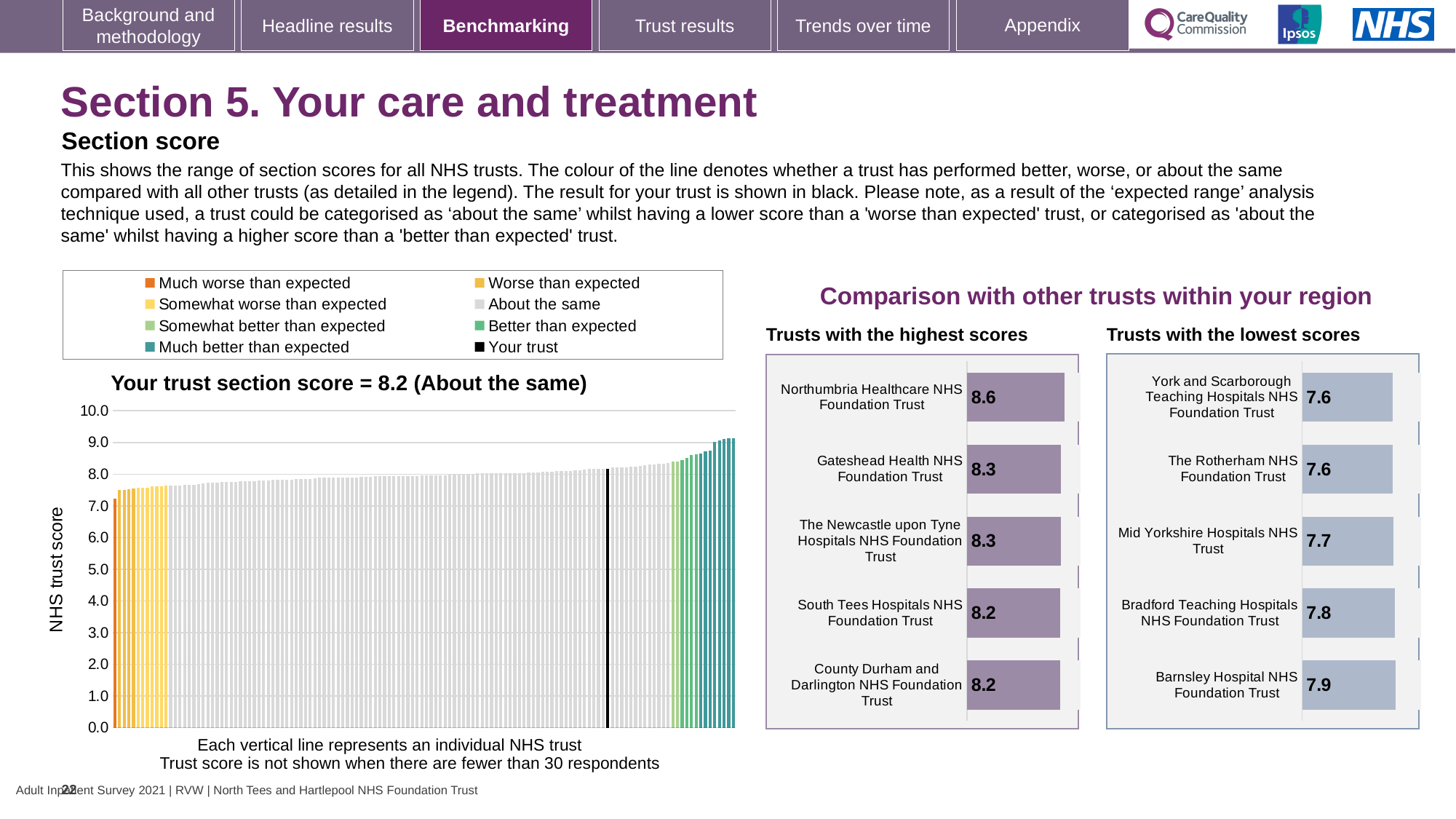
In the 'Trusts with the lowest scores' chart, what is the score for Mid Yorkshire Hospitals NHS Trust? 7.7 What kind of chart is the 'Trusts with the highest scores' chart? Bar chart How many entries does the legend of the main chart of all NHS trusts list? 8 How many trusts are shown in the 'Trusts with the lowest scores' chart? 5 In the 'Trusts with the lowest scores' chart, which trust has the highest score? Barnsley Hospital NHS Foundation Trust In the 'Trusts with the lowest scores' chart, what is the difference between the scores of Barnsley Hospital NHS Foundation Trust and York and Scarborough Teaching Hospitals NHS Foundation Trust? 0.3 In the 'Trusts with the highest scores' chart, what is the difference between the scores of Northumbria Healthcare NHS Foundation Trust and Gateshead Health NHS Foundation Trust? 0.3 In the 'Trusts with the highest scores' chart, what is the score for Northumbria Healthcare NHS Foundation Trust? 8.6 How many trusts are shown in the 'Trusts with the highest scores' chart? 5 In the 'Trusts with the lowest scores' chart, which has the larger score: Bradford Teaching Hospitals NHS Foundation Trust or Barnsley Hospital NHS Foundation Trust? Barnsley Hospital NHS Foundation Trust In the main chart of all NHS trusts, what is your trust's section score? 8.2 In the 'Trusts with the highest scores' chart, which trust has the highest score? Northumbria Healthcare NHS Foundation Trust